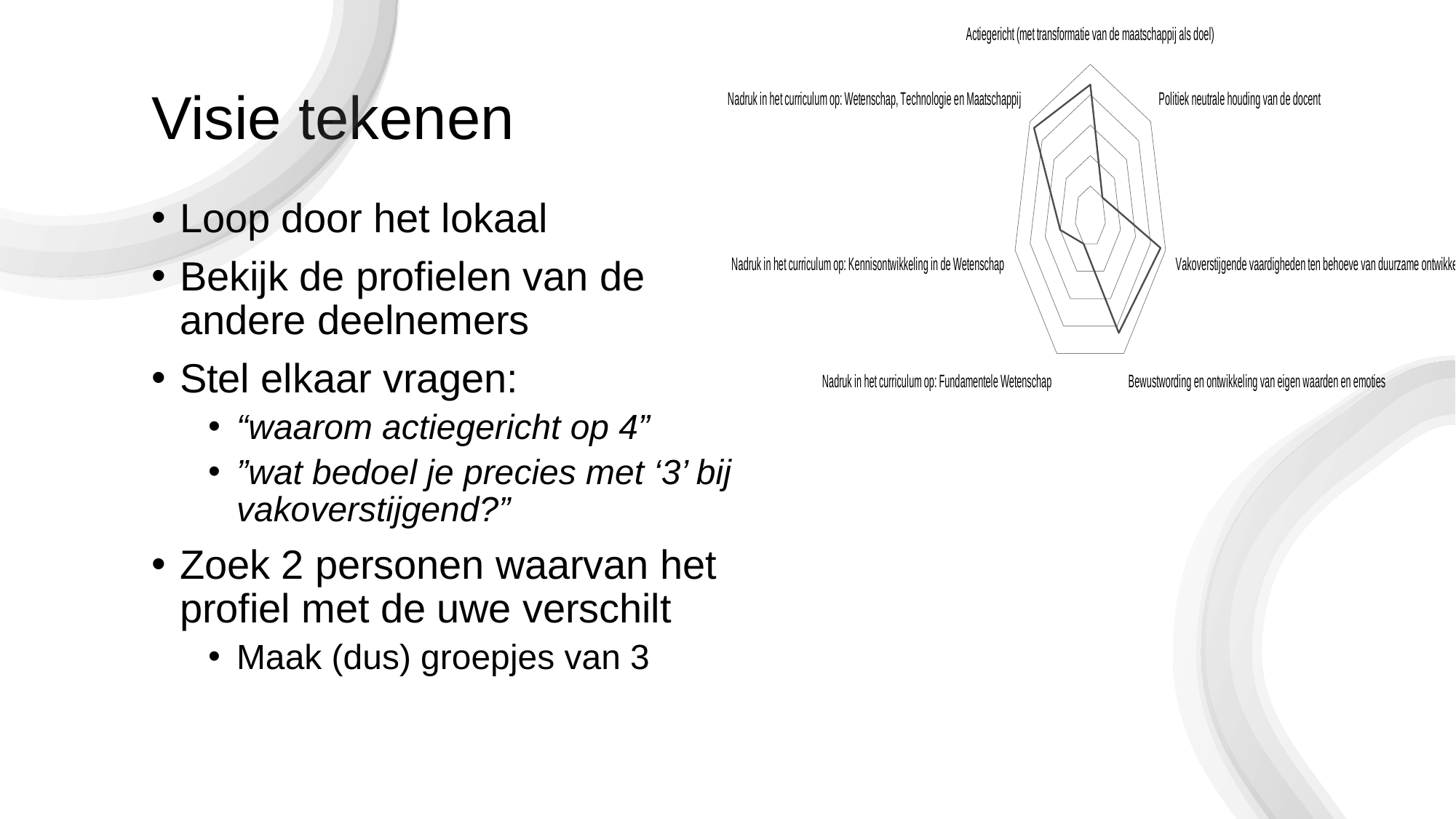
On the radar chart, which is larger: the value for 'Nadruk in het curriculum op: Wetenschap, Technologie en Maatschappij' or for 'Nadruk in het curriculum op: Kennisontwikkeling in de Wetenschap'? Nadruk in het curriculum op: Wetenschap, Technologie en Maatschappij How many categories (axes) does the radar chart have? 7 Which category label appears at the lower right of the radar chart? Bewustwording en ontwikkeling van eigen waarden en emoties How many data series are plotted on the radar chart? 1 Which category label appears at the top of the radar chart? Actiegericht (met transformatie van de maatschappij als doel) What kind of chart is shown on the right side of the slide? Radar chart On the radar chart, which is larger: the value for 'Vakoverstijgende vaardigheden ten behoeve van duurzame ontwikkeling' or for 'Nadruk in het curriculum op: Kennisontwikkeling in de Wetenschap'? Vakoverstijgende vaardigheden ten behoeve van duurzame ontwikkeling On the radar chart, which is larger: the value for 'Actiegericht (met transformatie van de maatschappij als doel)' or for 'Politiek neutrale houding van de docent'? Actiegericht (met transformatie van de maatschappij als doel)